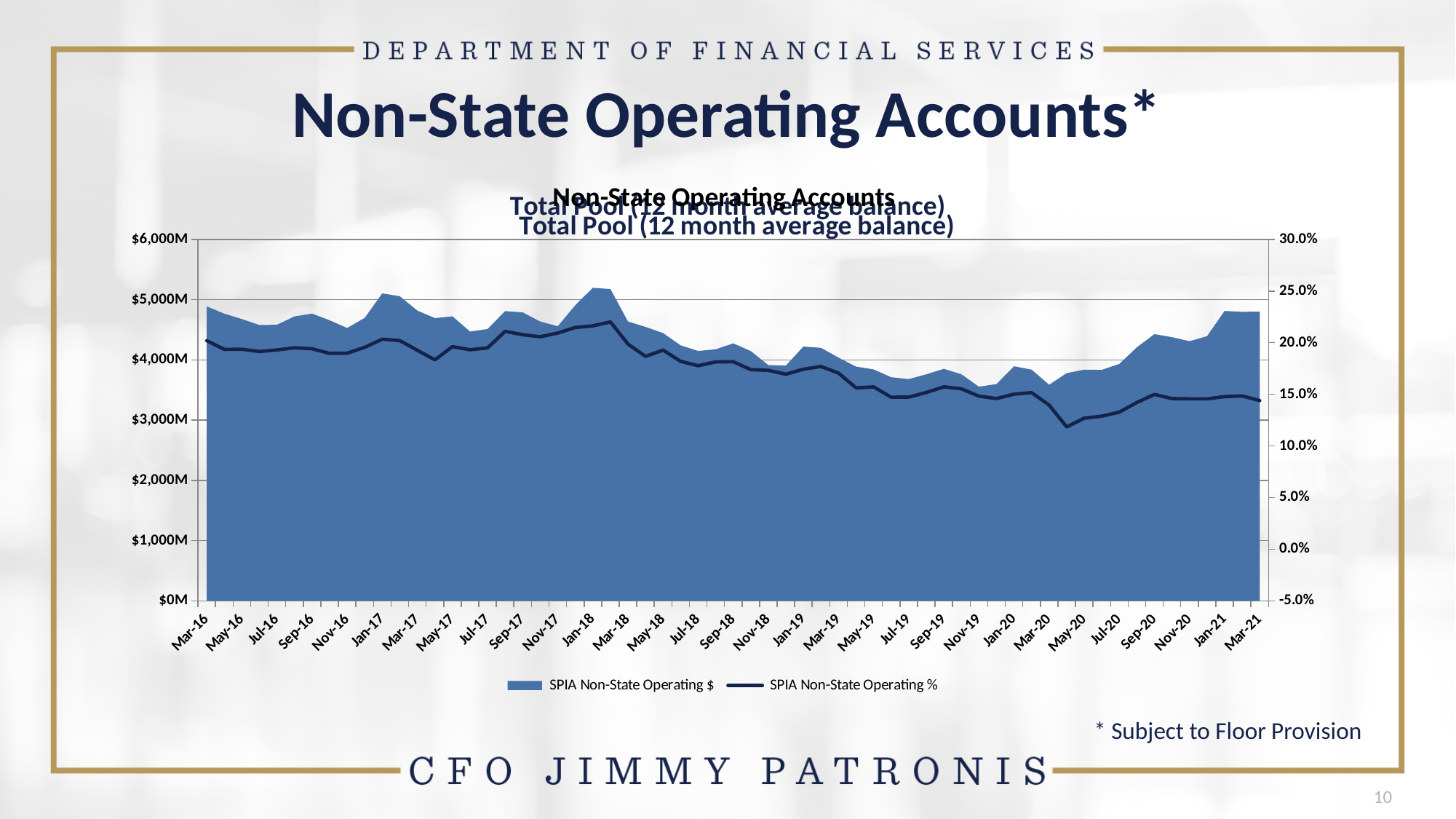
Which is larger, the SPIA Non-State Operating $ value for Jan-18 or for May-20? Jan-18 Is the SPIA Non-State Operating $ value for May-20 greater or less than $4,000M? less Which month shows the lowest SPIA Non-State Operating % value? Apr-20 What is the first month label on the x axis of the chart? Mar-16 What kind of chart is shown on the slide? A combination chart with a filled area for dollars and a line for percent Is the SPIA Non-State Operating $ value for Mar-16 greater or less than $4,000M? greater How many series does the chart legend list? 2 Is the SPIA Non-State Operating % value for May-20 greater or less than 15.0%? less What are the two series named in the chart legend? SPIA Non-State Operating $ and SPIA Non-State Operating % Does the SPIA Non-State Operating % line rise or fall between Mar-18 and May-20? fall